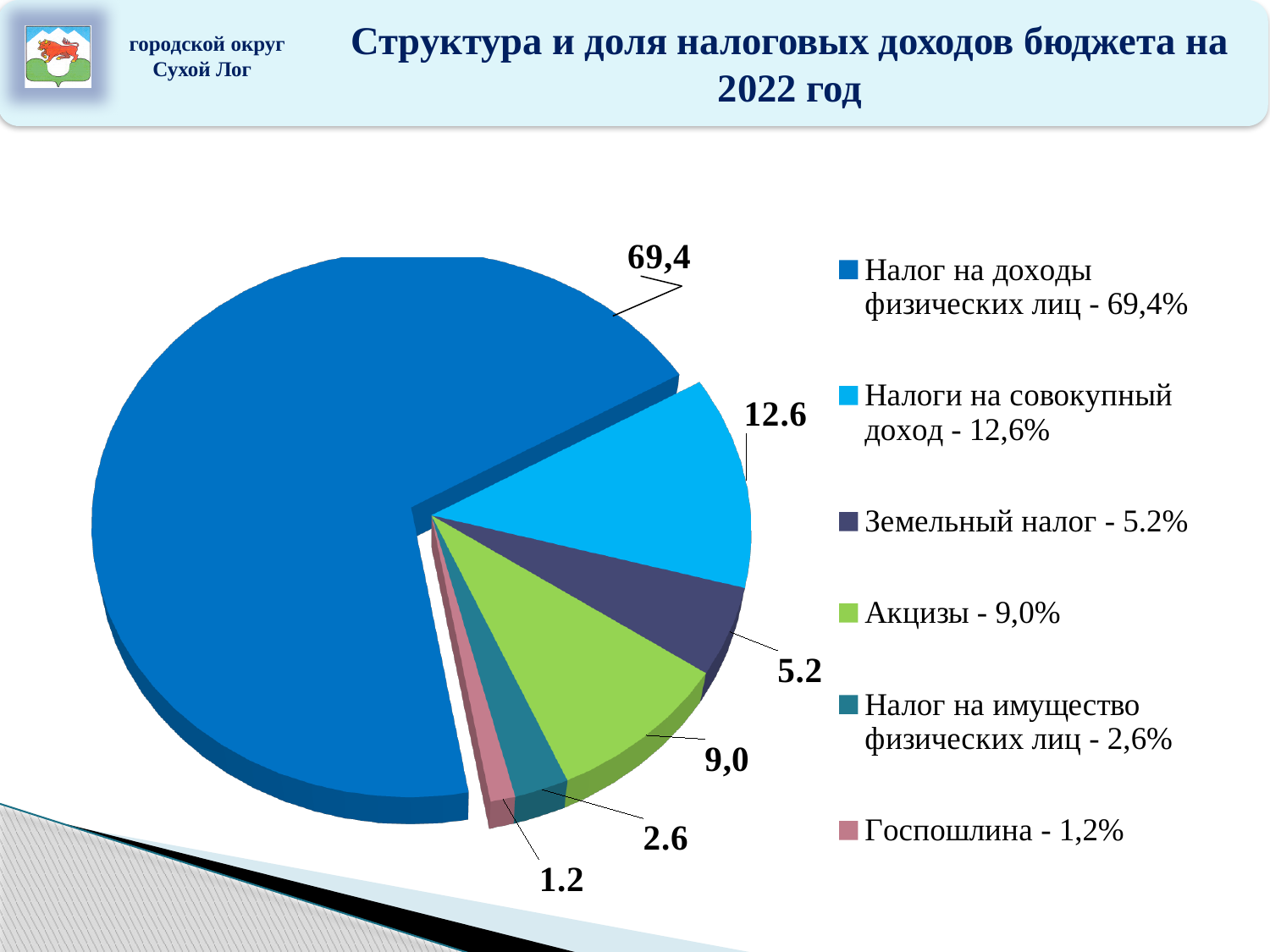
What is the data label on the slice for Налоги на совокупный доход? 12.6 What is the data label on the slice for Госпошлина? 1.2 What is the data label on the slice for Налог на доходы физических лиц? 69,4 How many entries does the legend list? 6 What is the title of the chart slide? Структура и доля налоговых доходов бюджета на 2022 год What is the data label on the slice for Акцизы? 9,0 Which is larger, the slice for Акцизы or the slice for Земельный налог? Акцизы Which category has the largest slice of the pie? Налог на доходы физических лиц Which category has the smallest slice of the pie? Госпошлина What kind of chart is shown on the slide? pie chart What is the data label on the slice for Земельный налог? 5.2 How many slices does the pie chart have? 6